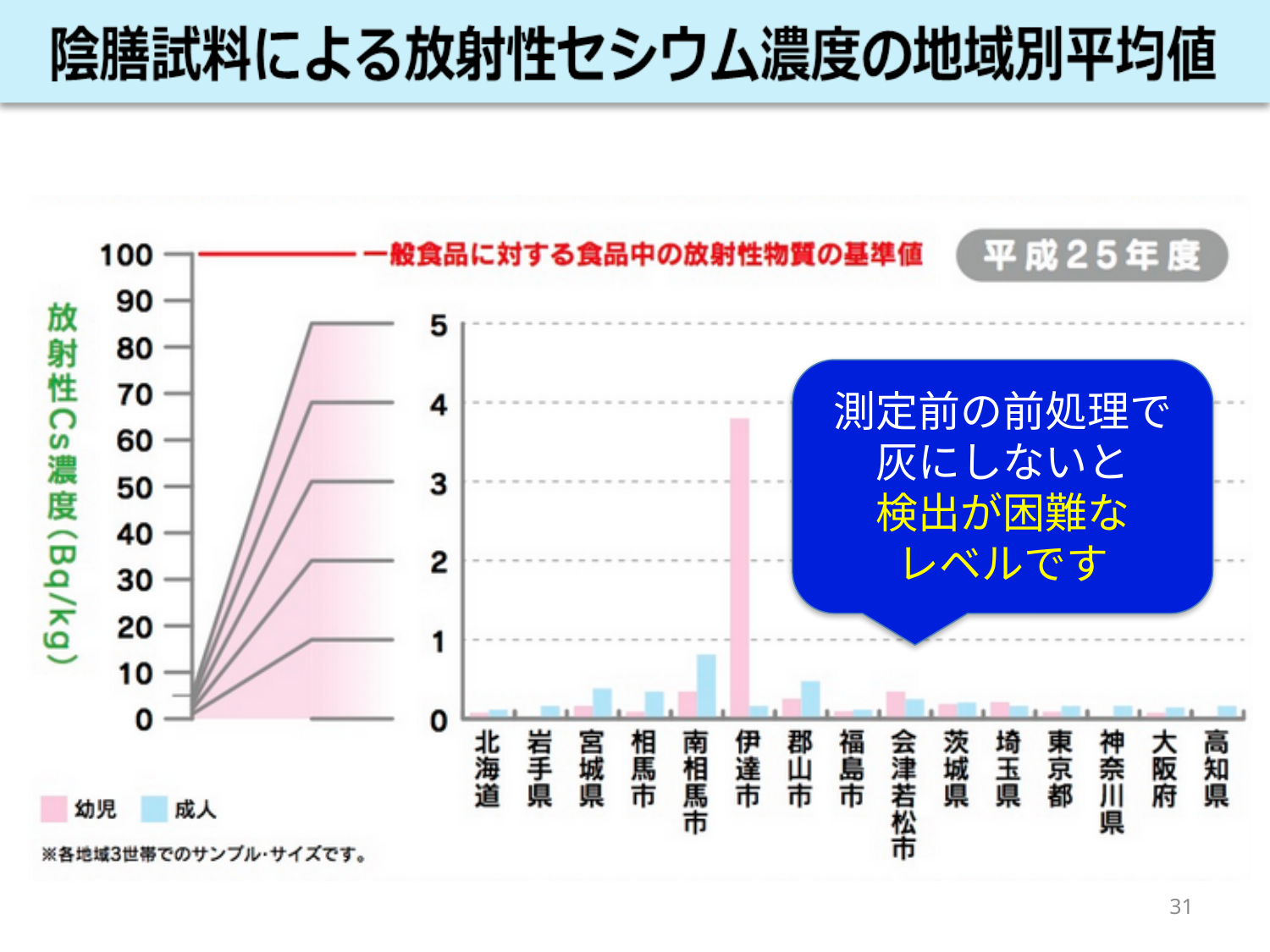
Which is larger, the 幼児 value for 伊達市 or the 幼児 value for 郡山市? 伊達市 For 南相馬市, which is larger, the 幼児 value or the 成人 value? 成人 How many series does the legend list? 2 What kind of chart is shown on the slide? bar chart Which region has the highest 幼児 value? 伊達市 Is the 幼児 value for 伊達市 greater or less than 4? less How many regions (categories) are shown on the x axis? 15 What fiscal year is shown in the label at the top right of the chart? 平成25年度 What are the two series named in the legend? 幼児 and 成人 Which region has the highest 成人 value? 南相馬市 Is the 幼児 value for 伊達市 greater or less than 3? greater Is the 成人 value for 南相馬市 greater or less than 1? less